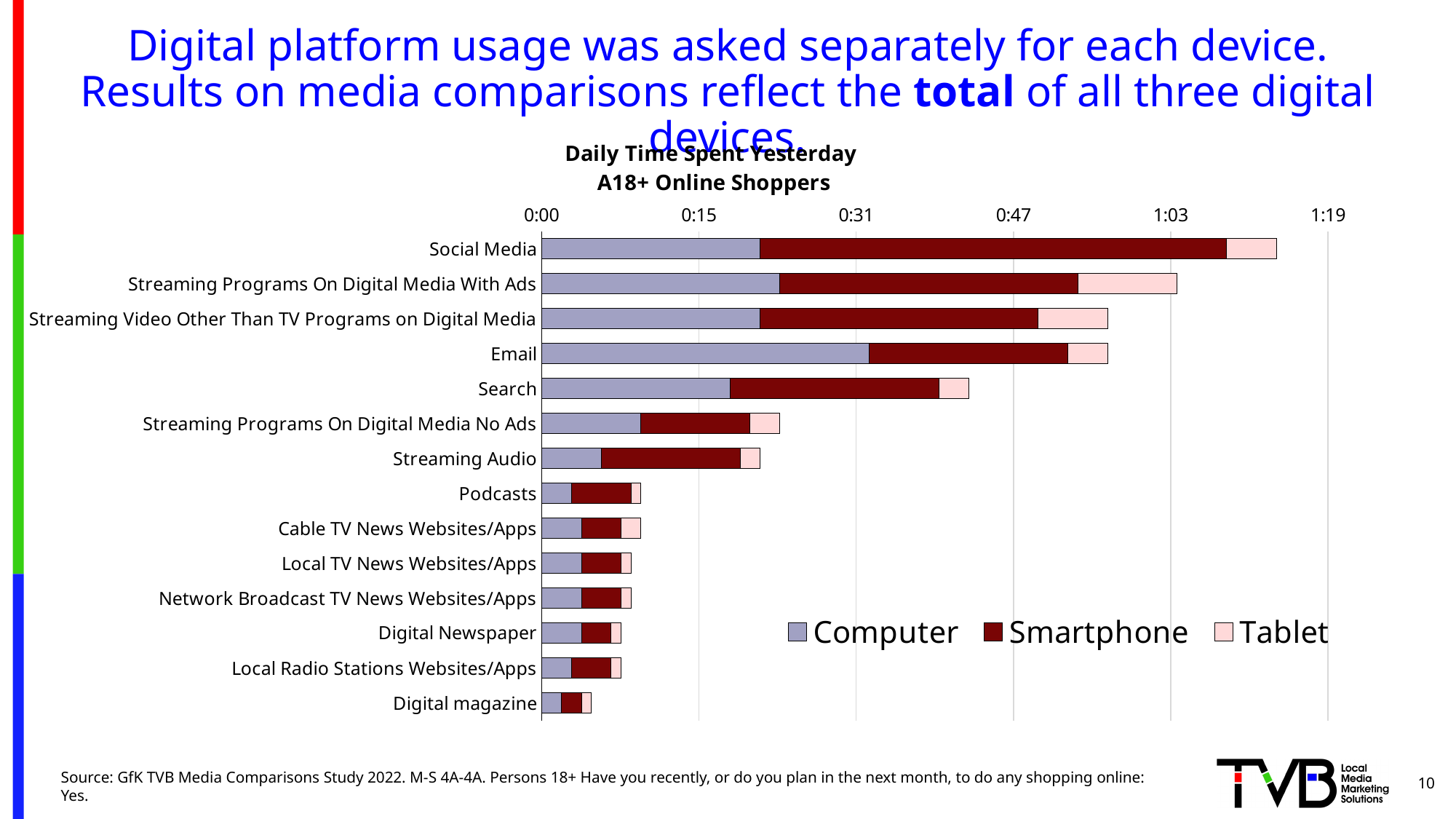
Which category has the shortest total bar? Digital magazine Is the total daily time for Social Media greater or less than 1:03? greater How many digital platform categories are plotted in the chart? 14 Which has a longer total bar, Search or Streaming Audio? Search Is the total daily time for Search greater or less than 0:31? greater Which category has the longest total bar? Social Media How many series does the legend list? 3 Is the total daily time for Digital magazine greater or less than 0:15? less Which has a longer total bar, Social Media or Email? Social Media What is the title of the chart? Daily Time Spent Yesterday A18+ Online Shoppers What kind of chart is shown on the slide? Stacked bar chart Which series are listed in the legend? Computer, Smartphone, Tablet